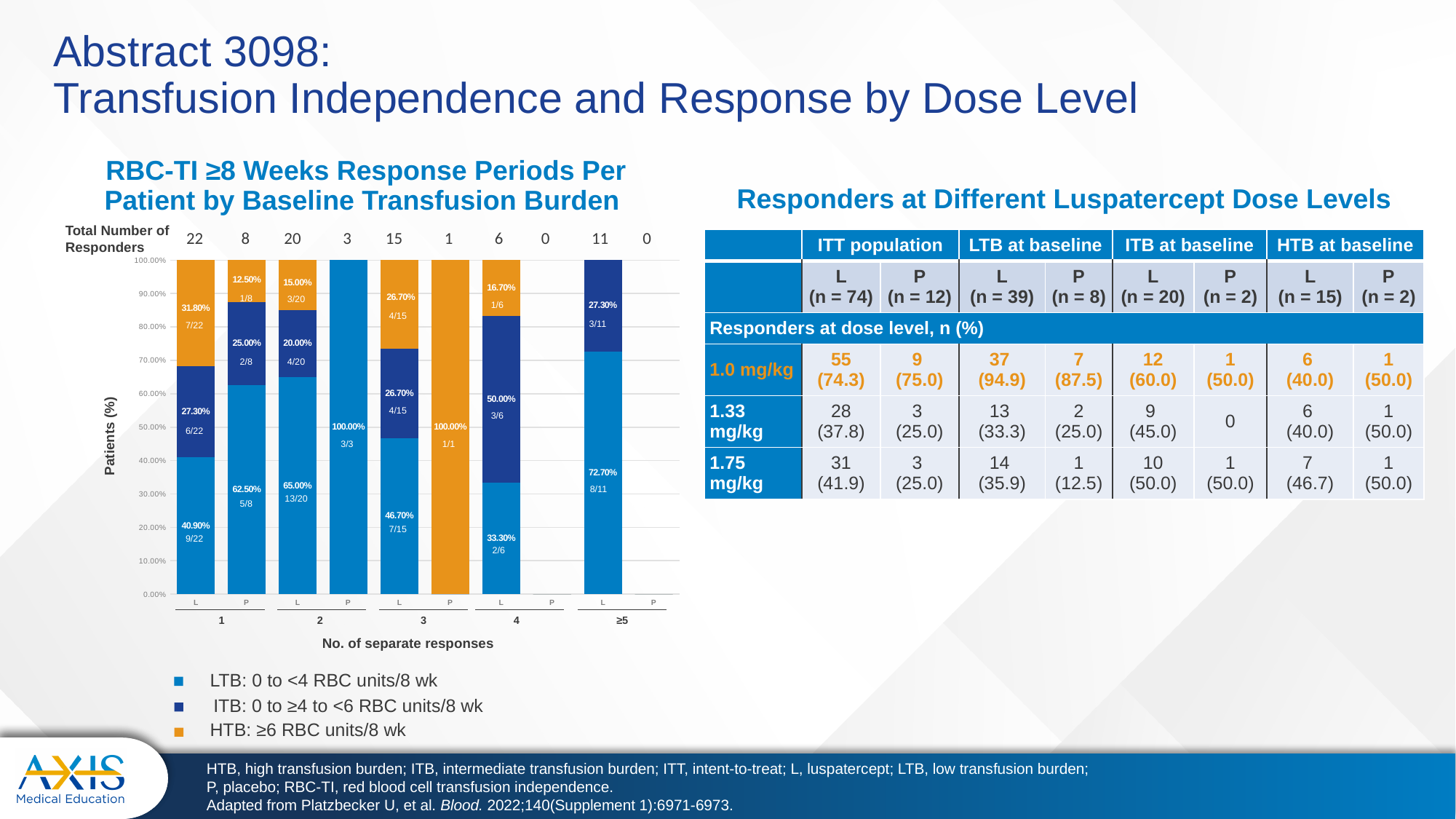
What type of chart is shown on the left of the slide? Stacked bar chart In the chart, what is the total number of responders for luspatercept (L) with 2 separate responses? 20 In the luspatercept (L) bar for ≥5 separate responses, what is the difference between the LTB and ITB percentages? 45.40% In the chart, what percentage of luspatercept (L) patients with 4 separate responses had ITB at baseline? 50.00% In the luspatercept (L) bar for 1 separate response, which segment is larger: LTB or HTB? LTB What is the x-axis title of the chart? No. of separate responses In the chart, what percentage of luspatercept (L) patients with 1 separate response had LTB at baseline? 40.90% How many series (transfusion burden categories) does the chart legend list? 3 In the chart, what fraction label is shown for the HTB segment of the luspatercept (L) bar with 2 separate responses? 3/20 How many bars in the chart have a total number of responders of 0? 2 Among the luspatercept (L) bars in the chart, which number of separate responses has the highest LTB percentage? ≥5 In the chart, what percentage of luspatercept (L) patients with 3 separate responses had HTB at baseline? 26.70%